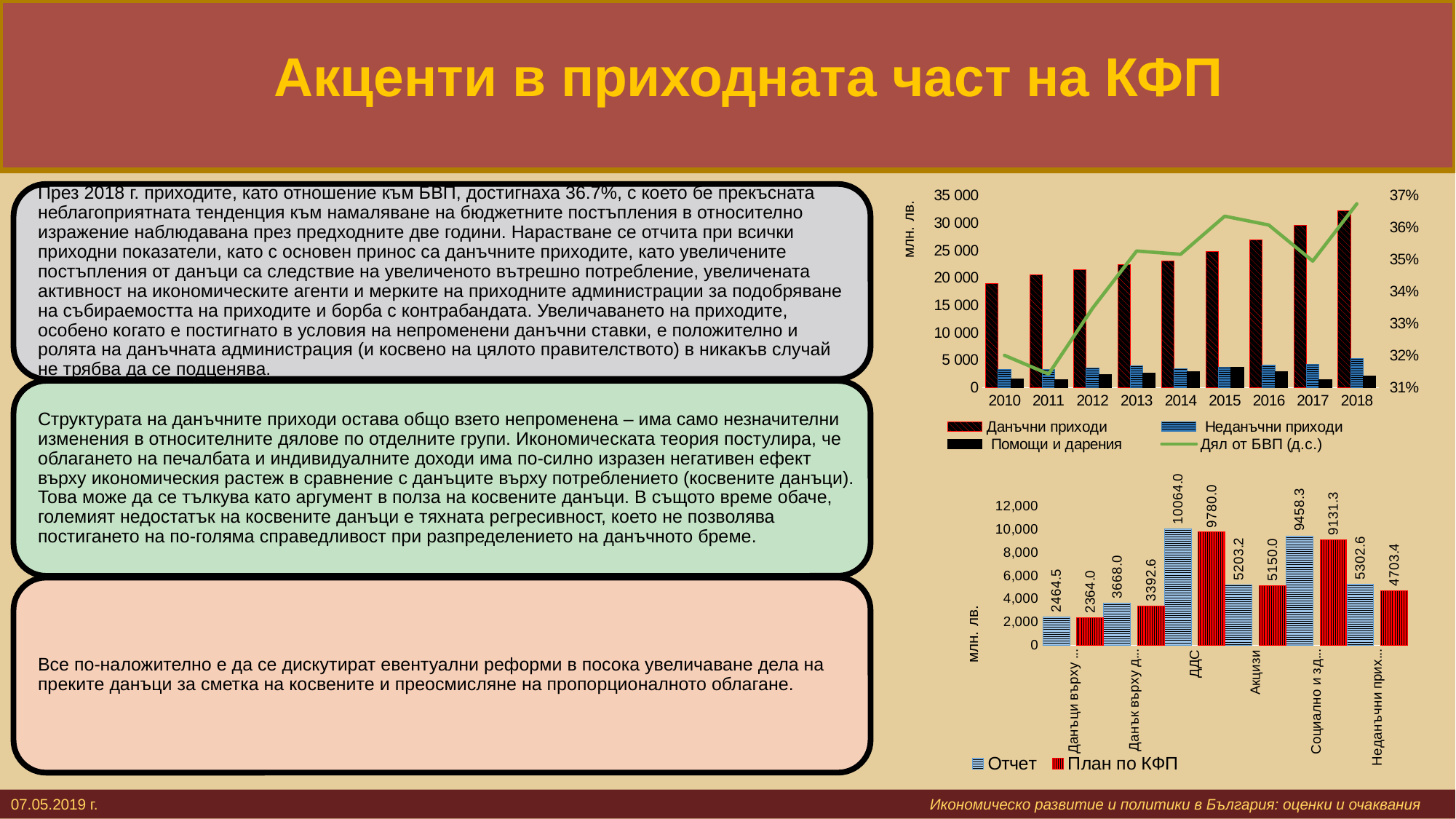
In the top chart, how many years are shown on the x axis? 9 In the bottom chart, what is the Отчет value for ДДС? 10064.0 In the bottom chart, what is the План по КФП value for Акцизи? 5150.0 In the bottom chart, which is larger for Акцизи: Отчет or План по КФП? Отчет In the top chart, how many series does the legend list? 4 In the bottom chart, what is the difference between the Отчет and План по КФП values for ДДС? 284.0 What kind of chart is the bottom chart? bar chart In the top chart, is the value of Данъчни приходи for 2018 greater or less than 30 000? greater In the bottom chart, which category has the highest Отчет value? ДДС In the top chart, is the value of Данъчни приходи for 2010 greater or less than 20 000? less In the top chart, do the Данъчни приходи bars rise or fall from 2010 to 2018? rise In the top chart, is the value of Дял от БВП (д.с.) for 2011 greater or less than 32%? less